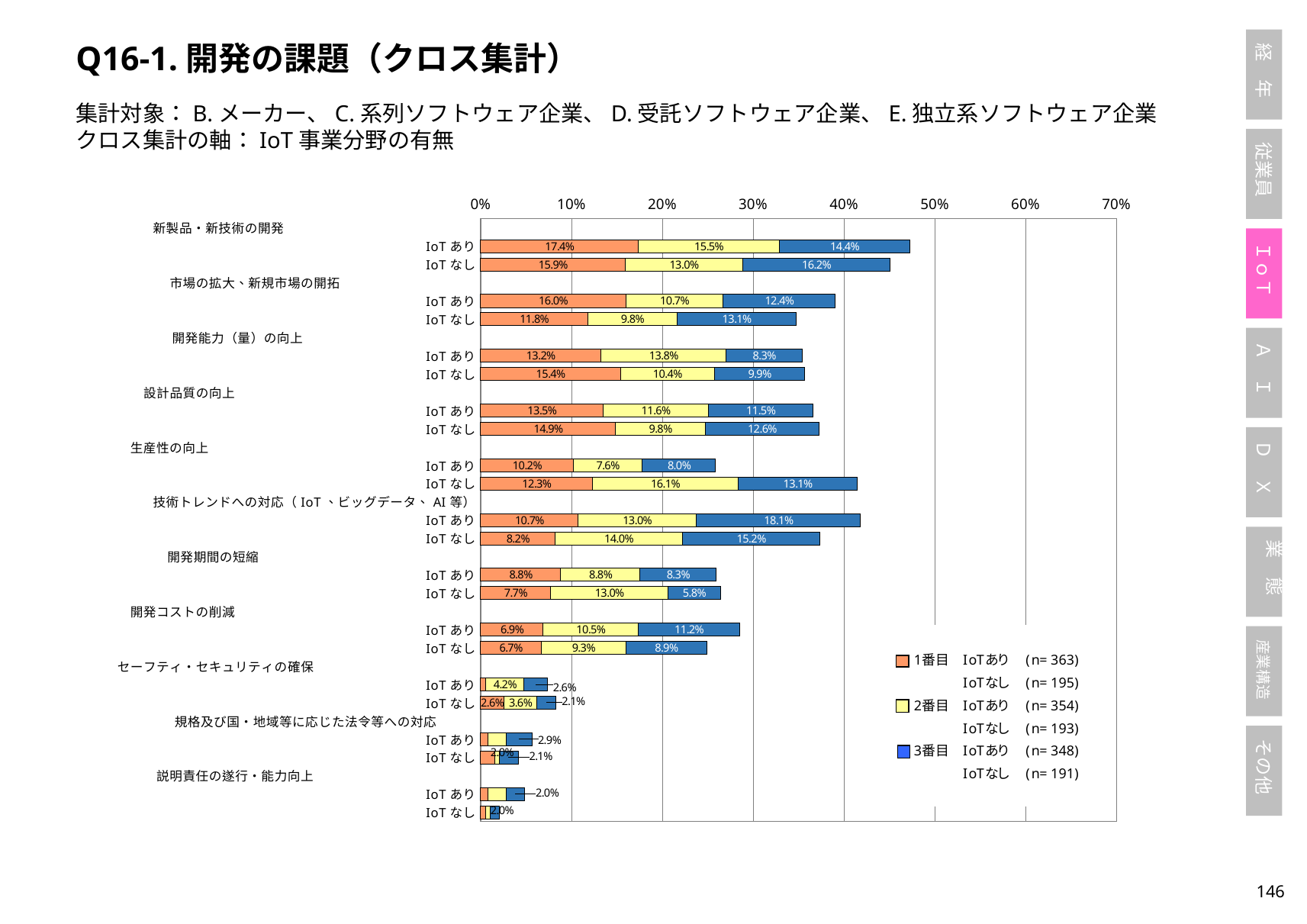
How many series does the legend list? 3 What is the 1番目 value for 新製品・新技術の開発 in the IoT あり bar? 17.4% Which category has the longest IoT あり stacked bar? 新製品・新技術の開発 What is the total of the IoT あり stacked bar for 新製品・新技術の開発? 47.3% What is the 3番目 value for 技術トレンドへの対応（IoT、ビッグデータ、AI等） in the IoT あり bar? 18.1% What is the 2番目 value for 開発期間の短縮 in the IoT なし bar? 13.0% What is the difference between the 1番目 values for 新製品・新技術の開発 in the IoT あり bar and the IoT なし bar? 1.5 percentage points According to the legend, what is the n for 1番目 IoT あり? 363 What type of chart is shown on the slide? bar chart How many development challenge categories are plotted on the chart? 11 Is the total of the IoT あり stacked bar for 開発コストの削減 greater or less than 20%? greater For 生産性の向上, which has the larger 2番目 value, IoT あり or IoT なし? IoT なし